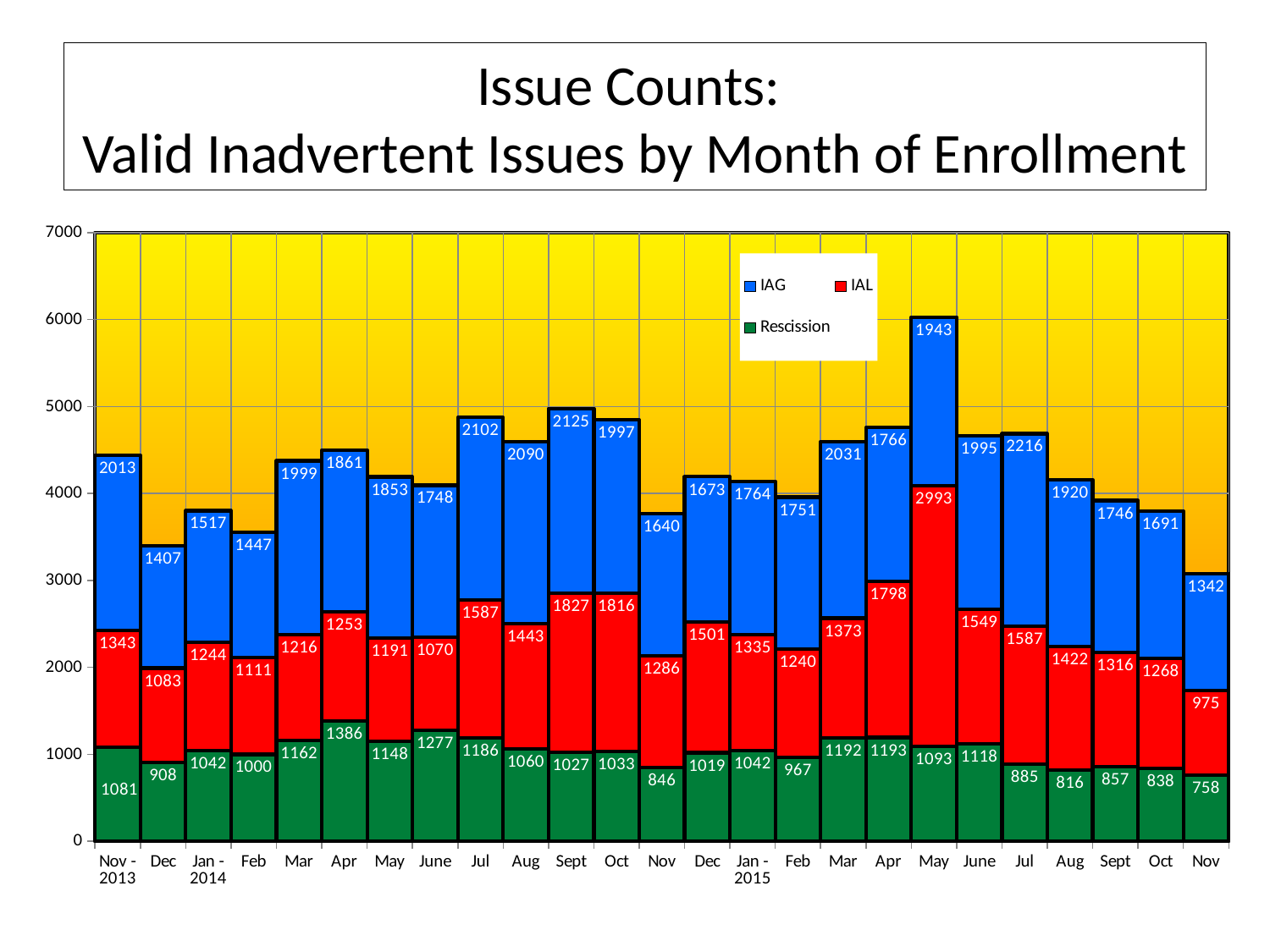
What is the total of the stacked bar for Nov 2015? 3075 What is the Rescission value for Apr 2014? 1386 Which is larger, the IAG value for Sept 2014 or the IAG value for Aug 2014? Sept 2014 What is the IAG value for Nov 2013? 2013 Is the total stacked value for May 2015 greater or less than 6000? greater Which month has the highest IAG value? Jul 2015 How many series does the legend list? 3 What is the difference between the IAL values for May 2015 and June 2015? 1444 Which month has the lowest Rescission value? Nov 2015 How many months are shown on the x axis? 25 What is the IAL value for May 2015? 2993 What kind of chart is shown on the slide? Stacked bar chart